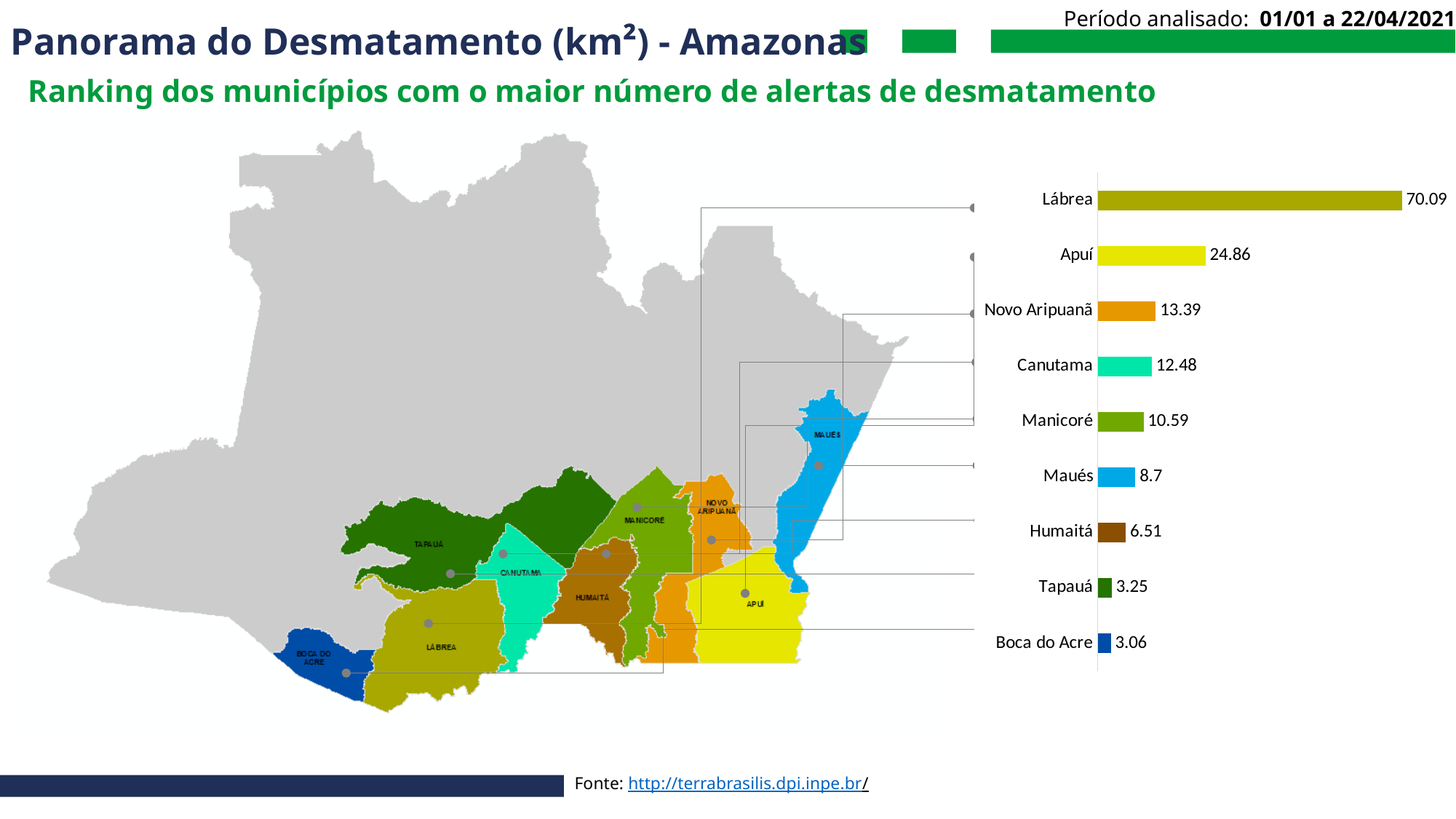
What is the value for Maués? 8.7 Which municipality has the highest value? Lábrea What is the difference between the values for Novo Aripuanã and Canutama? 0.91 What kind of chart is used to show the ranking? bar chart What is the value for Lábrea? 70.09 Which municipality has the lowest value? Boca do Acre What is the difference between the values for Lábrea and Apuí? 45.23 What is the value for Canutama? 12.48 Which is larger, the value for Humaitá or the value for Tapauá? Humaitá What is the value for Boca do Acre? 3.06 How many municipalities are shown in the bar chart? 9 What colour is the bar for Maués? light blue